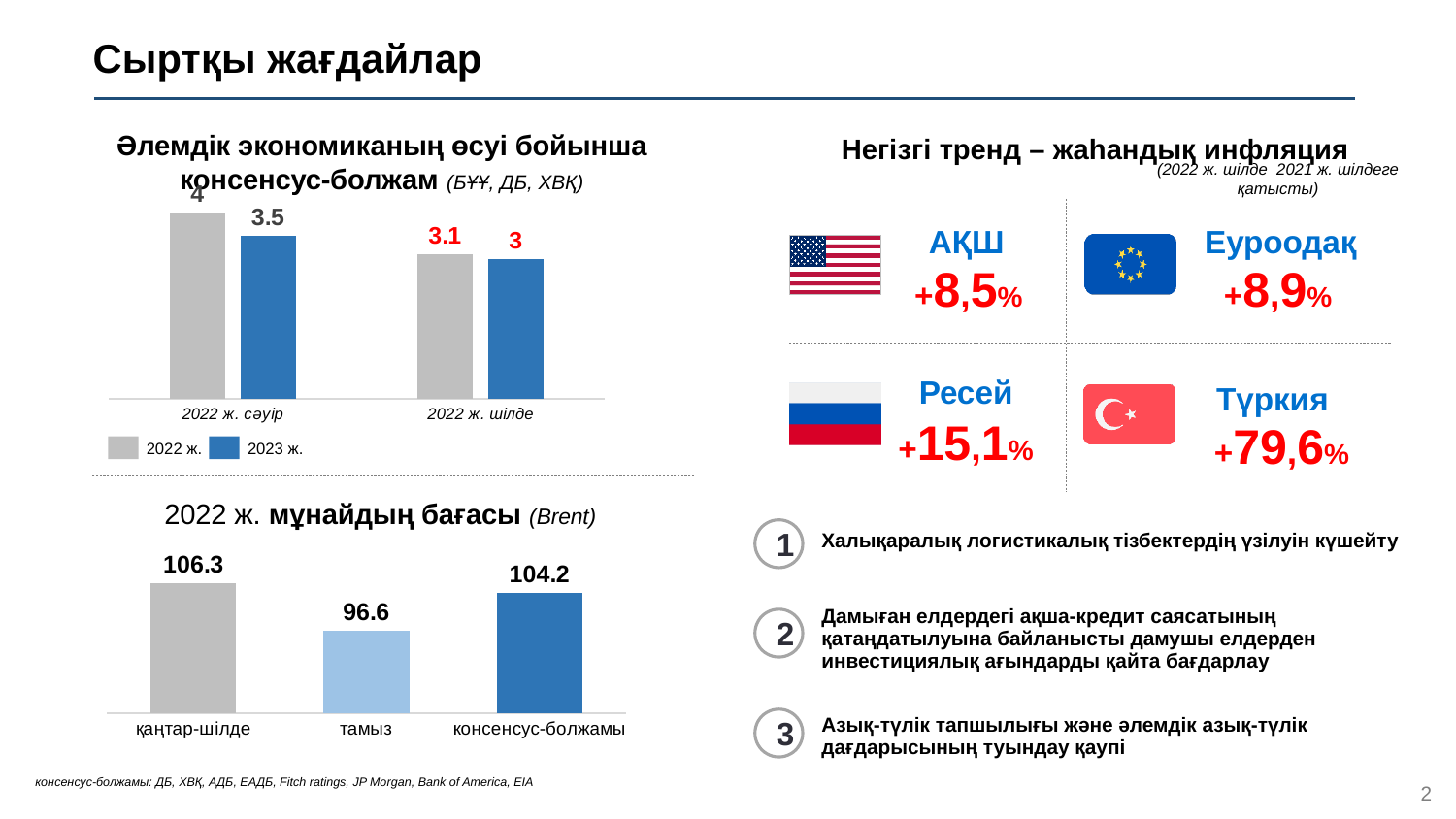
In the chart titled "2022 ж. мұнайдың бағасы (Brent)", which category has the lowest value? тамыз In the chart titled "2022 ж. мұнайдың бағасы (Brent)", what is the difference between the қаңтар-шілде value and the консенсус-болжамы value? 2.1 In the chart titled "2022 ж. мұнайдың бағасы (Brent)", what is the value for тамыз? 96.6 In the chart titled "Әлемдік экономиканың өсуі бойынша консенсус-болжам", what is the value for the 2023 ж. series in the 2022 ж. шілде group? 3 In the chart titled "2022 ж. мұнайдың бағасы (Brent)", which category has the highest value? қаңтар-шілде In the chart titled "Әлемдік экономиканың өсуі бойынша консенсус-болжам", what colour are the 2023 ж. bars? Blue In the chart titled "Әлемдік экономиканың өсуі бойынша консенсус-болжам", which group has the higher 2022 ж. value, 2022 ж. сәуір or 2022 ж. шілде? 2022 ж. сәуір In the chart titled "Әлемдік экономиканың өсуі бойынша консенсус-болжам", what is the value for the 2022 ж. series in the 2022 ж. шілде group? 3.1 In the chart titled "Әлемдік экономиканың өсуі бойынша консенсус-болжам", what is the value for the 2022 ж. series in the 2022 ж. сәуір group? 4 What kind of chart is the one titled "2022 ж. мұнайдың бағасы (Brent)"? Bar chart In the chart titled "Әлемдік экономиканың өсуі бойынша консенсус-болжам", how many series does the legend list? 2 In the chart titled "Әлемдік экономиканың өсуі бойынша консенсус-болжам", what is the difference between the 2023 ж. values for 2022 ж. сәуір and 2022 ж. шілде? 0.5